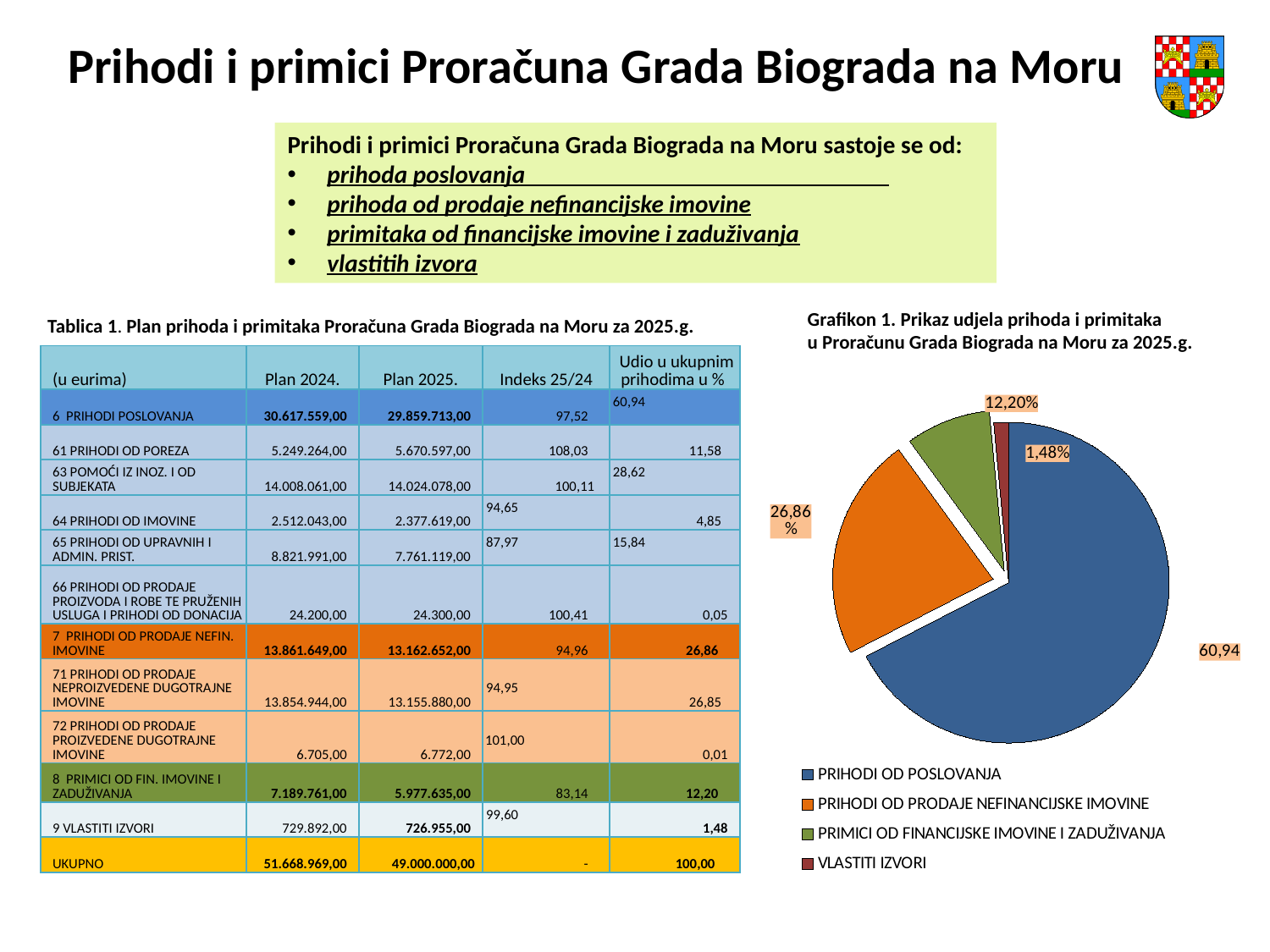
What is the title of the pie chart? Grafikon 1. Prikaz udjela prihoda i primitaka u Proračunu Grada Biograda na Moru za 2025.g. What kind of chart is shown on the slide? pie chart Which is larger in the pie chart: PRIHODI OD PRODAJE NEFINANCIJSKE IMOVINE or PRIMICI OD FINANCIJSKE IMOVINE I ZADUŽIVANJA? PRIHODI OD PRODAJE NEFINANCIJSKE IMOVINE What is the value shown for PRIMICI OD FINANCIJSKE IMOVINE I ZADUŽIVANJA in the pie chart? 12,20% Which category has the smallest slice in the pie chart? VLASTITI IZVORI Which category has the largest slice in the pie chart? PRIHODI OD POSLOVANJA What is the value shown for VLASTITI IZVORI in the pie chart? 1,48% How many slices does the pie chart have? 4 How many entries does the pie chart's legend list? 4 What is the difference between the PRIHODI OD POSLOVANJA slice and the PRIHODI OD PRODAJE NEFINANCIJSKE IMOVINE slice in the pie chart? 34,08 What is the value shown for PRIHODI OD POSLOVANJA in the pie chart? 60,94 What is the value shown for PRIHODI OD PRODAJE NEFINANCIJSKE IMOVINE in the pie chart? 26,86 %